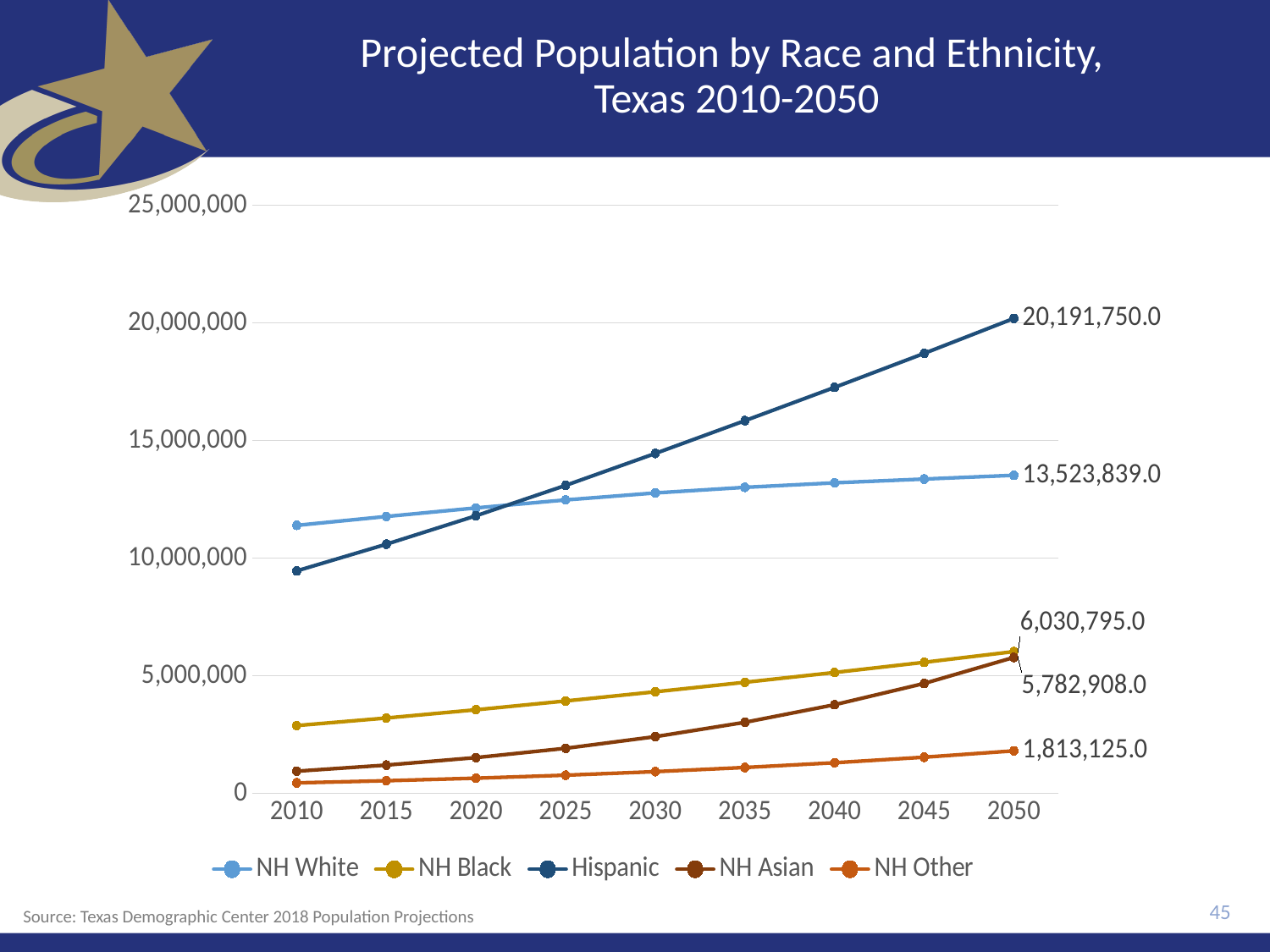
Is the Hispanic population in 2010 greater or less than 10,000,000? less How many series does the legend list? 5 What is the projected NH Black population in 2050? 6,030,795.0 What kind of chart is shown on the slide? Line chart What is the projected NH White population in Texas in 2050? 13,523,839.0 What is the projected Hispanic population in Texas in 2050? 20,191,750.0 What is the projected NH Other population in 2050? 1,813,125.0 Which group has the highest projected population in 2050? Hispanic Which group has the lowest projected population in 2050? NH Other What is the difference between the Hispanic and NH White projected populations in 2050? 6,667,911.0 What is the projected NH Asian population in 2050? 5,782,908.0 Which group has the larger projected population in 2010, NH White or Hispanic? NH White